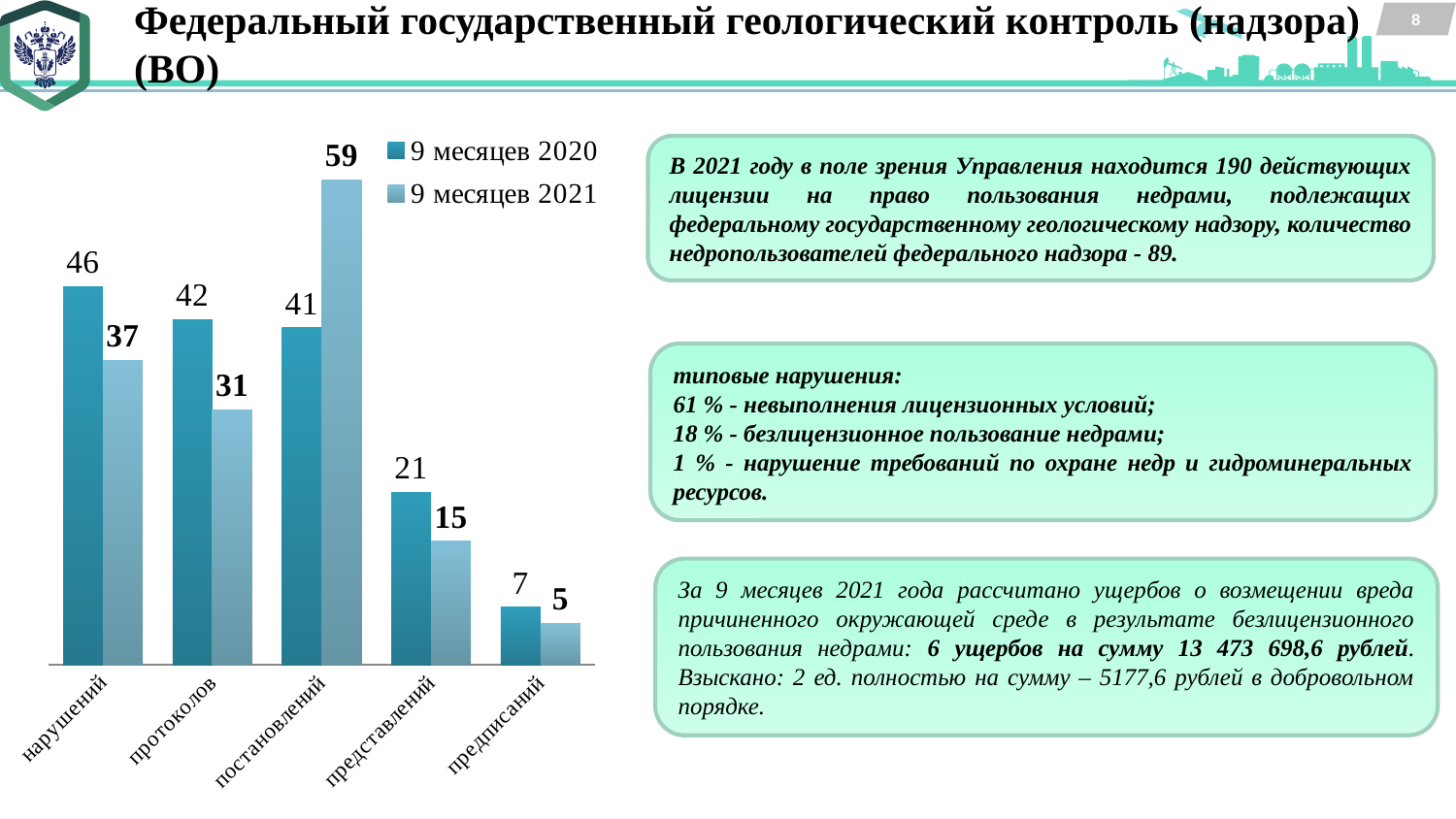
How many categories are shown on the x axis of the chart? 5 What is the difference between the 9 месяцев 2021 and 9 месяцев 2020 values for постановлений? 18 Which category has the highest value in the 9 месяцев 2020 series? нарушений What is the value for предписаний in the 9 месяцев 2021 series? 5 What is the value for постановлений in the 9 месяцев 2021 series? 59 What is the difference between the 9 месяцев 2020 and 9 месяцев 2021 values for протоколов? 11 How many series does the legend list? 2 Which is larger for представлений: the 9 месяцев 2020 value or the 9 месяцев 2021 value? 9 месяцев 2020 What are the two series named in the legend? 9 месяцев 2020 and 9 месяцев 2021 Which category has the lowest value in the 9 месяцев 2021 series? предписаний What is the value for нарушений in the 9 месяцев 2020 series? 46 What kind of chart is shown on the slide? bar chart